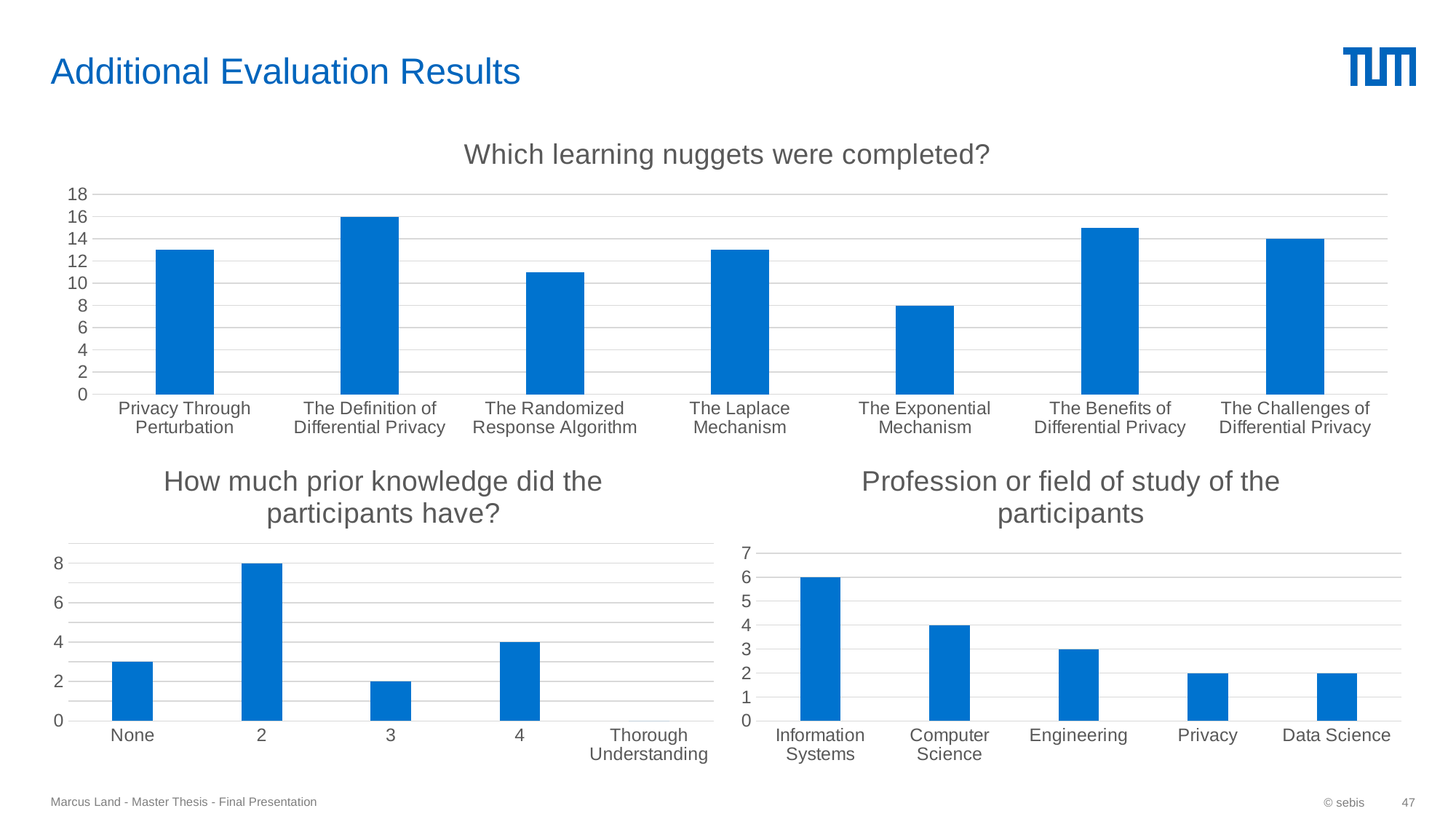
In the chart 'Which learning nuggets were completed?', is the value for The Randomized Response Algorithm greater or less than 12? less In the chart 'Which learning nuggets were completed?', what is the value for The Exponential Mechanism? 8 In the chart 'Which learning nuggets were completed?', which learning nugget has the highest value? The Definition of Differential Privacy In the chart 'Which learning nuggets were completed?', what is the value for The Definition of Differential Privacy? 16 In the chart 'How much prior knowledge did the participants have?', what is the value for the category '2'? 8 In the chart 'Which learning nuggets were completed?', how many learning nuggets are shown? 7 In the chart 'Profession or field of study of the participants', what is the difference between Information Systems and Computer Science? 2 What kind of chart is 'Profession or field of study of the participants'? Bar chart In the chart 'How much prior knowledge did the participants have?', which category has the lowest value? Thorough Understanding In the chart 'Which learning nuggets were completed?', which learning nugget has the lowest value? The Exponential Mechanism In the chart 'Profession or field of study of the participants', what is the value for Information Systems? 6 In the chart 'How much prior knowledge did the participants have?', which category has the highest value? 2